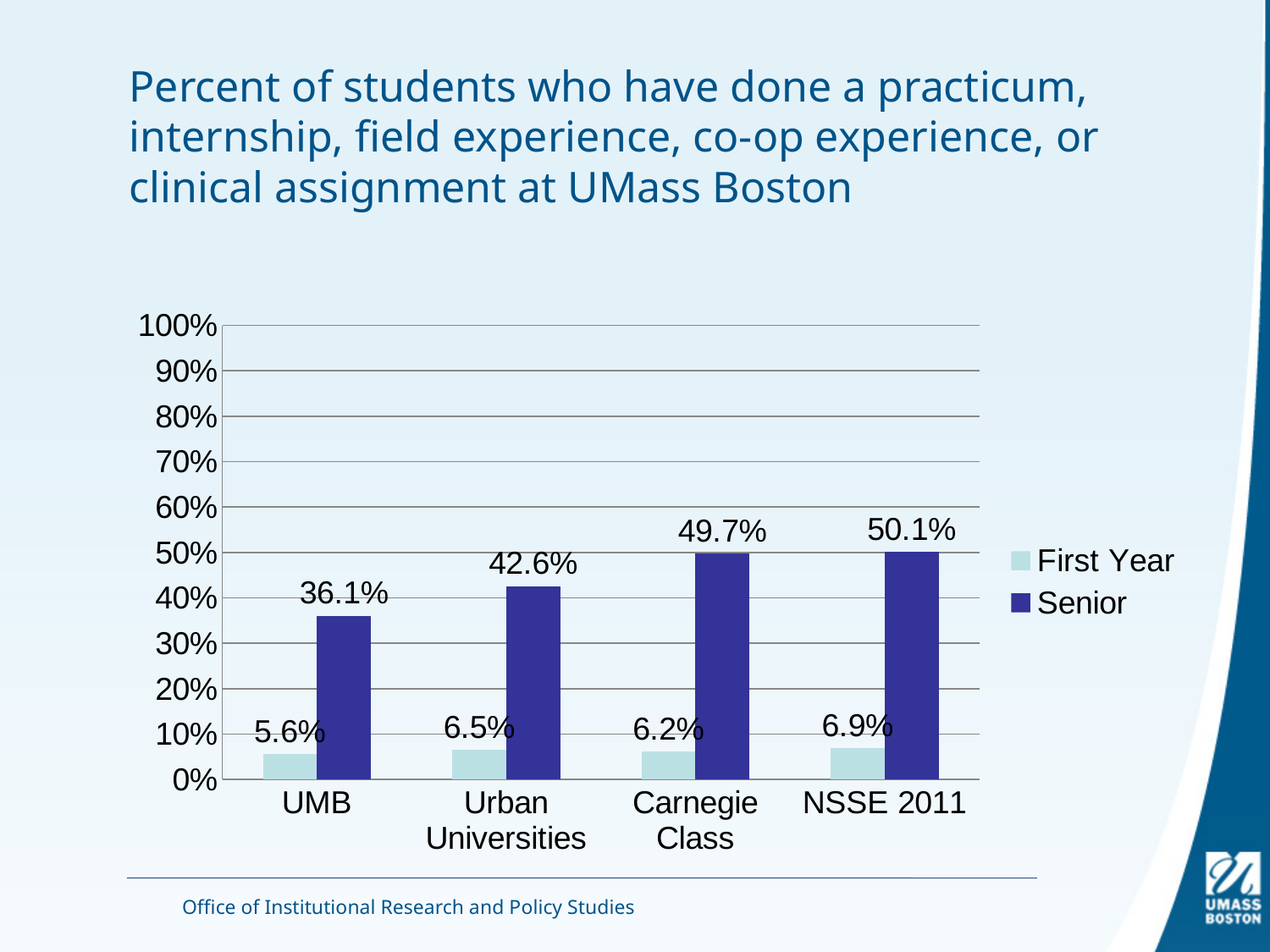
What is the difference between the Senior values for Urban Universities and UMB? 6.5% How many categories are shown on the x axis? 4 Which category has the lowest First Year value? UMB How many series does the legend list? 2 What is the difference between the Senior and First Year values for UMB? 30.5% Which is larger, the Senior value for Carnegie Class or the Senior value for Urban Universities? Carnegie Class What is the Senior value for UMB? 36.1% Which category has the highest Senior value? NSSE 2011 What is the First Year value for Urban Universities? 6.5% What is the First Year value for NSSE 2011? 6.9% What is the Senior value for Carnegie Class? 49.7% What kind of chart is shown on the slide? Bar chart